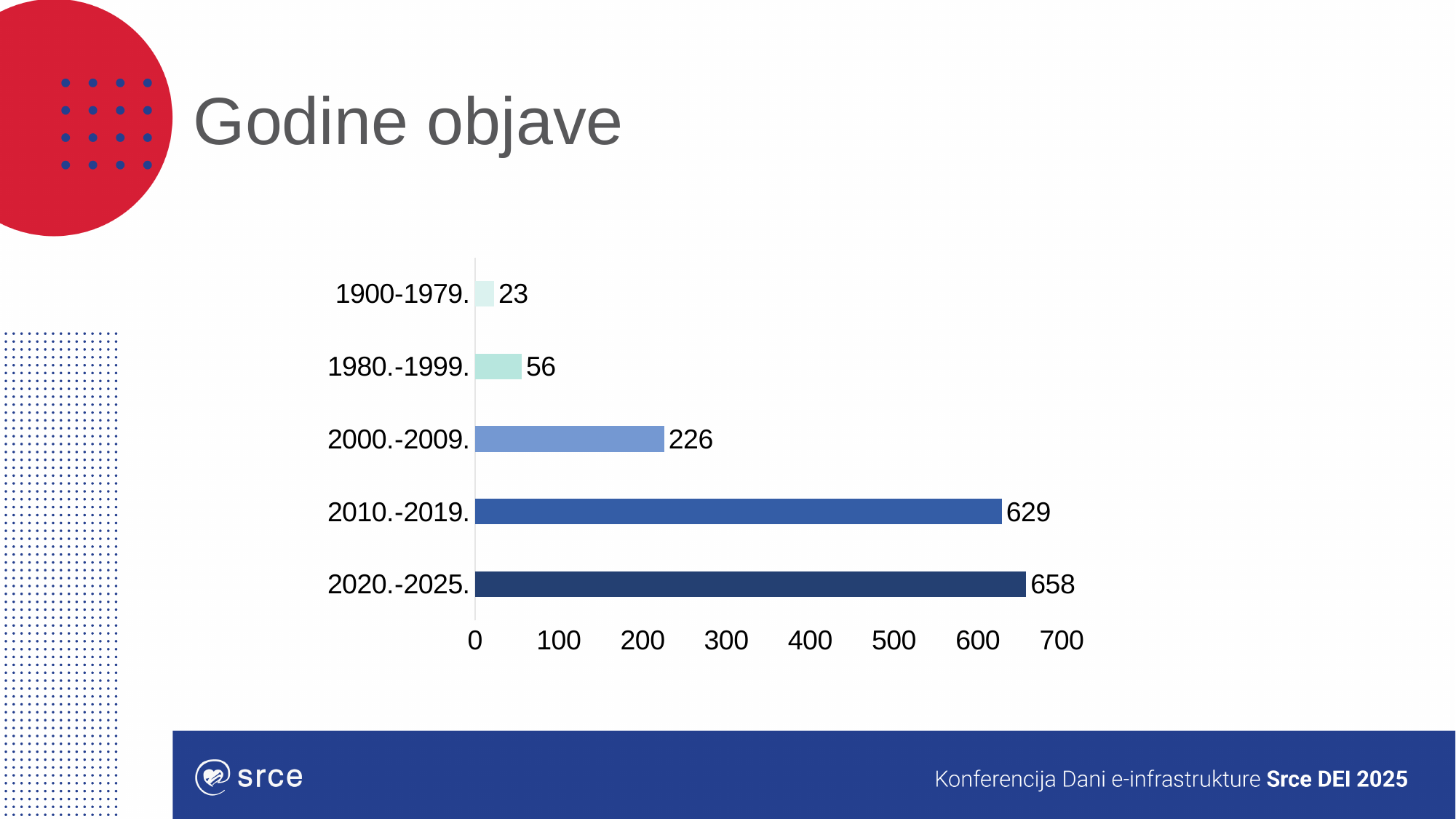
What kind of chart is shown on the slide? bar chart What is the value for 2010.-2019.? 629 Is the value for 2010.-2019. greater or less than 600? greater Which is larger, the value for 1980.-1999. or the value for 2000.-2009.? 2000.-2009. How many periods are shown in the chart? 5 Which period has the highest value? 2020.-2025. What is the value for 2000.-2009.? 226 What is the difference between the values for 2000.-2009. and 1980.-1999.? 170 Which period has the lowest value? 1900-1979. What is the value for 1900-1979.? 23 What is the title of the slide containing the chart? Godine objave What is the difference between the values for 2020.-2025. and 2010.-2019.? 29